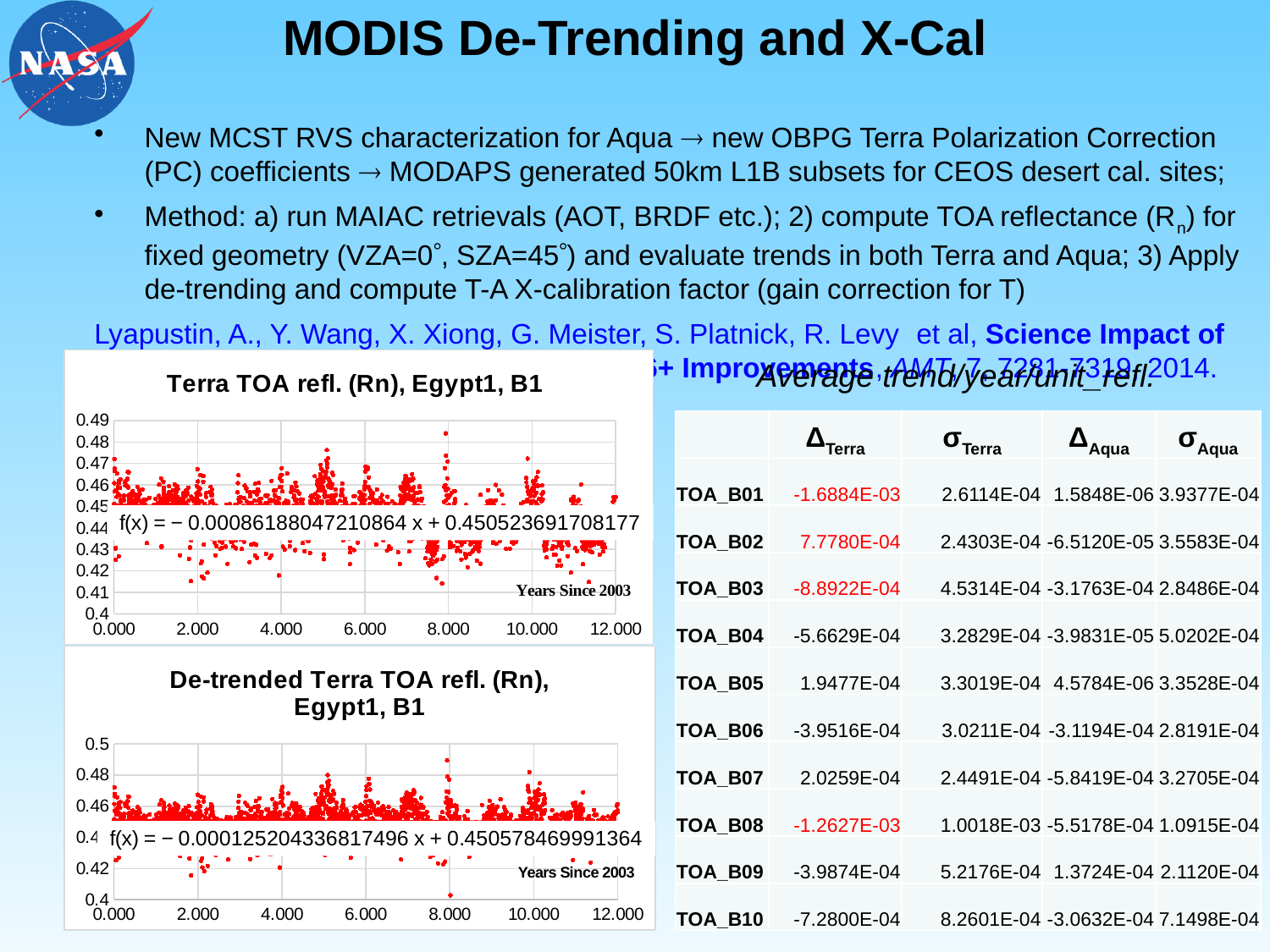
In the top chart "Terra TOA refl. (Rn), Egypt1, B1", is the slope of the fitted trend line positive or negative? negative What is the x-axis label of the top chart "Terra TOA refl. (Rn), Egypt1, B1"? Years Since 2003 In the top chart "Terra TOA refl. (Rn), Egypt1, B1", what is the largest tick value on the x axis? 12.000 In the bottom chart "De-trended Terra TOA refl. (Rn), Egypt1, B1", what is the fitted trend line equation shown? f(x) = − 0.000125204336817496 x + 0.450578469991364 What kind of chart is the top chart titled "Terra TOA refl. (Rn), Egypt1, B1"? scatter chart What is the title of the bottom chart on the slide? De-trended Terra TOA refl. (Rn), Egypt1, B1 According to the fitted trend line in the top chart "Terra TOA refl. (Rn), Egypt1, B1", do the values rise or fall with years since 2003? fall In the bottom chart "De-trended Terra TOA refl. (Rn), Egypt1, B1", what is the highest value shown on the y axis? 0.5 In the top chart "Terra TOA refl. (Rn), Egypt1, B1", what is the highest value shown on the y axis? 0.49 In the top chart "Terra TOA refl. (Rn), Egypt1, B1", what is the fitted trend line equation shown? f(x) = − 0.00086188047210864 x + 0.450523691708177 In the top chart "Terra TOA refl. (Rn), Egypt1, B1", is the highest plotted point (near 8 years since 2003) greater or less than 0.48? greater Which chart has the trend line with the smaller magnitude of slope, the top chart "Terra TOA refl. (Rn), Egypt1, B1" or the bottom chart "De-trended Terra TOA refl. (Rn), Egypt1, B1"? De-trended Terra TOA refl. (Rn), Egypt1, B1